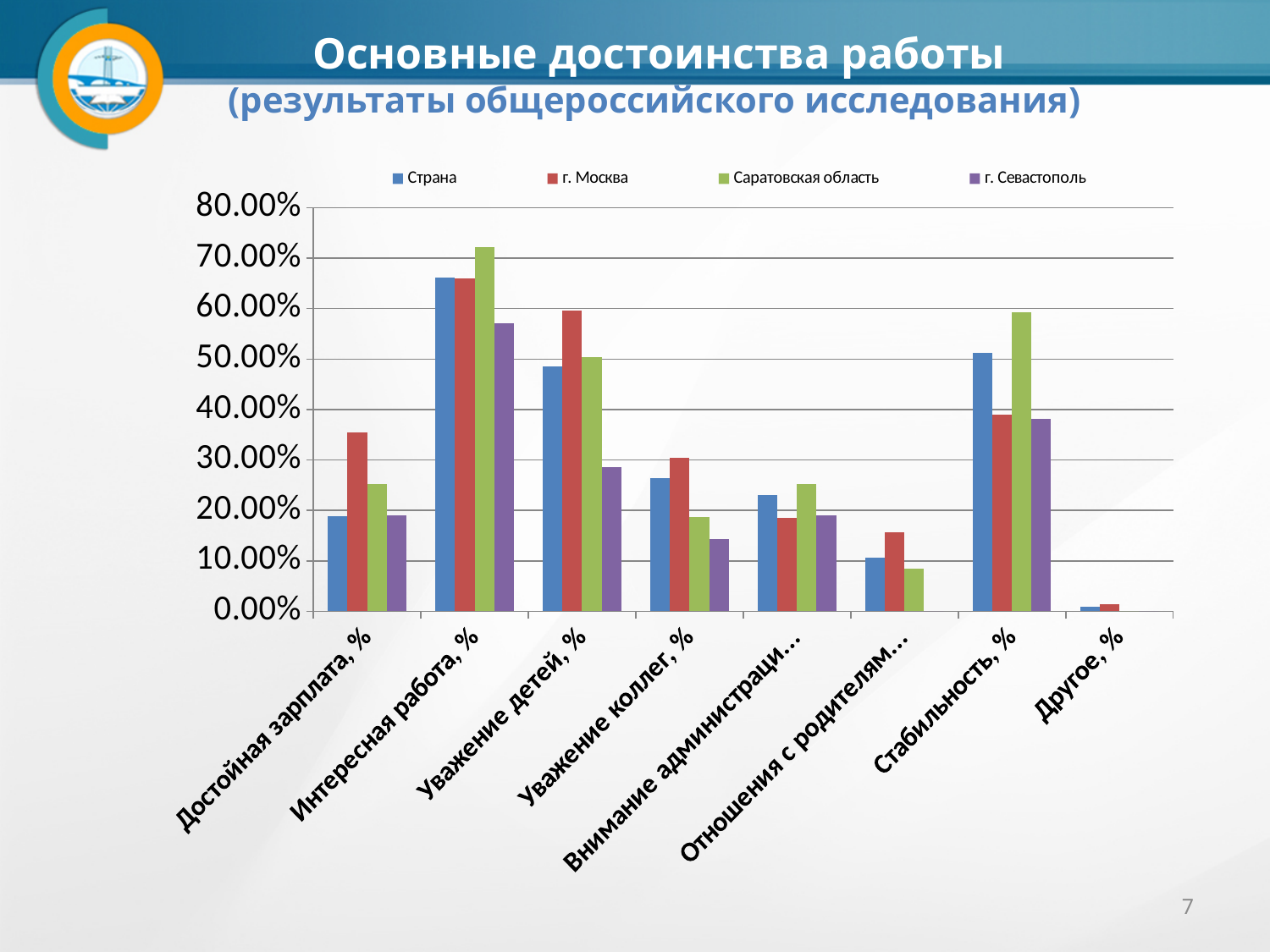
In the category Уважение детей, %, which is larger: the value for г. Москва or the value for Страна? г. Москва For the series Саратовская область, which category has the highest value? Интересная работа, % How many categories are shown along the x axis? 8 Is the value for Страна in the category Стабильность, % greater or less than 40.00%? greater Which series is shown in green in the legend? Саратовская область Is the value for г. Севастополь in the category Уважение коллег, % greater or less than 20.00%? less What kind of chart is shown on the slide? bar chart In the category Стабильность, %, which is larger: the value for Саратовская область or the value for г. Москва? Саратовская область Is the value for г. Москва in the category Достойная зарплата, % greater or less than 30.00%? greater How many series does the legend list? 4 For the series Страна, which category has the lowest value? Другое, % For the series г. Севастополь, which category has the highest value? Интересная работа, %